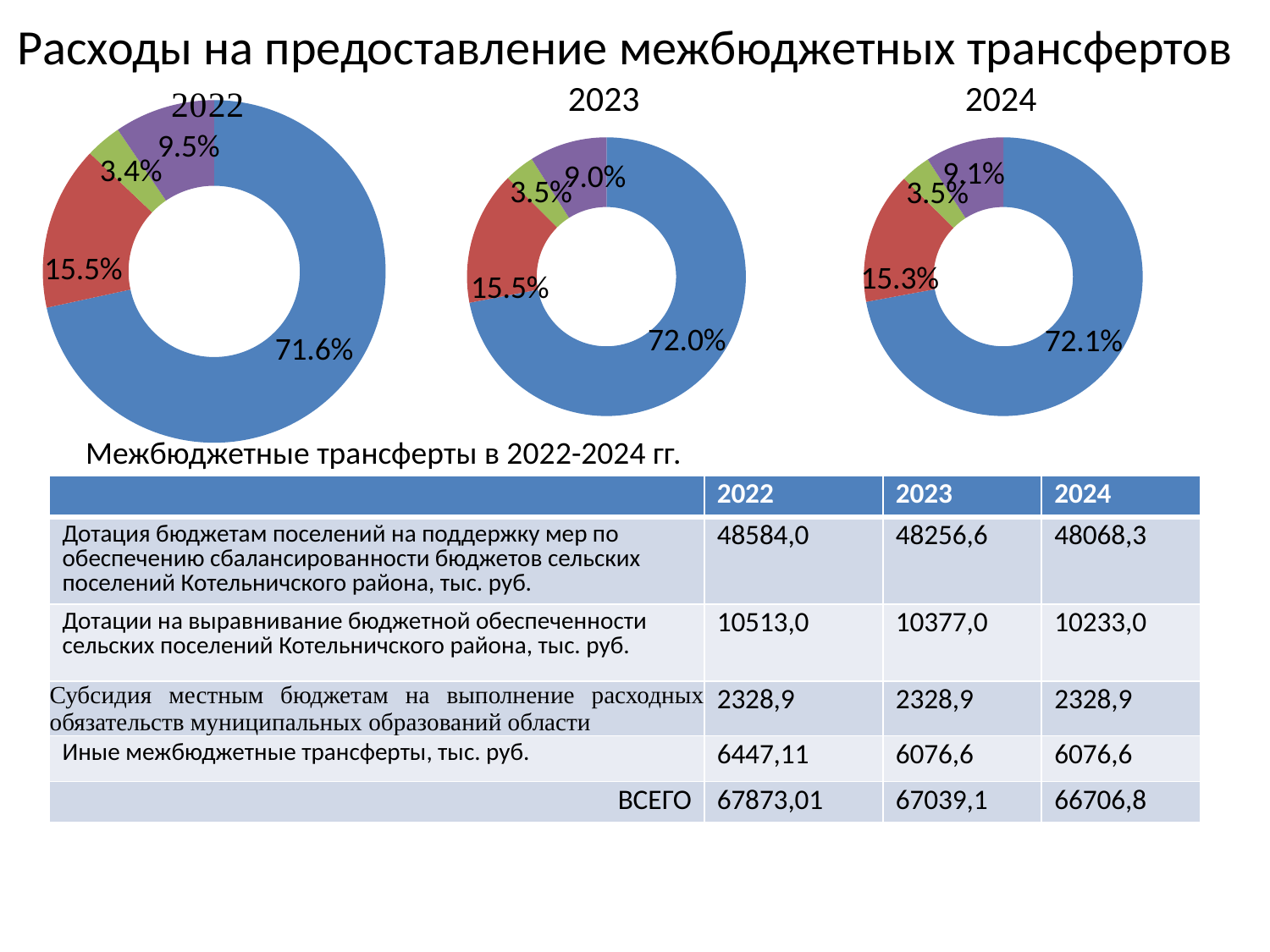
In the 2022 chart, what is the difference in percentage points between the largest slice and the second-largest slice? 56.1 percentage points In the 2024 chart, what is the value of the red slice? 15.3% What kind of chart is the 2022 chart? doughnut (pie) chart Which chart has the larger value for its largest slice, 2022 or 2024? 2024 How many slices does the 2023 chart have? 4 In the 2022 chart, what is the value of the smallest slice? 3.4% What is the difference in percentage points between the purple slice in the 2022 chart and the purple slice in the 2024 chart? 0.4 percentage points In the 2023 chart, what is the value of the purple slice? 9.0% In the 2023 chart, what is the value of the largest slice? 72.0% In the 2022 chart, what is the value of the largest slice? 71.6% In the 2024 chart, what is the value of the smallest slice? 3.5% How many doughnut charts are shown on the slide? 3